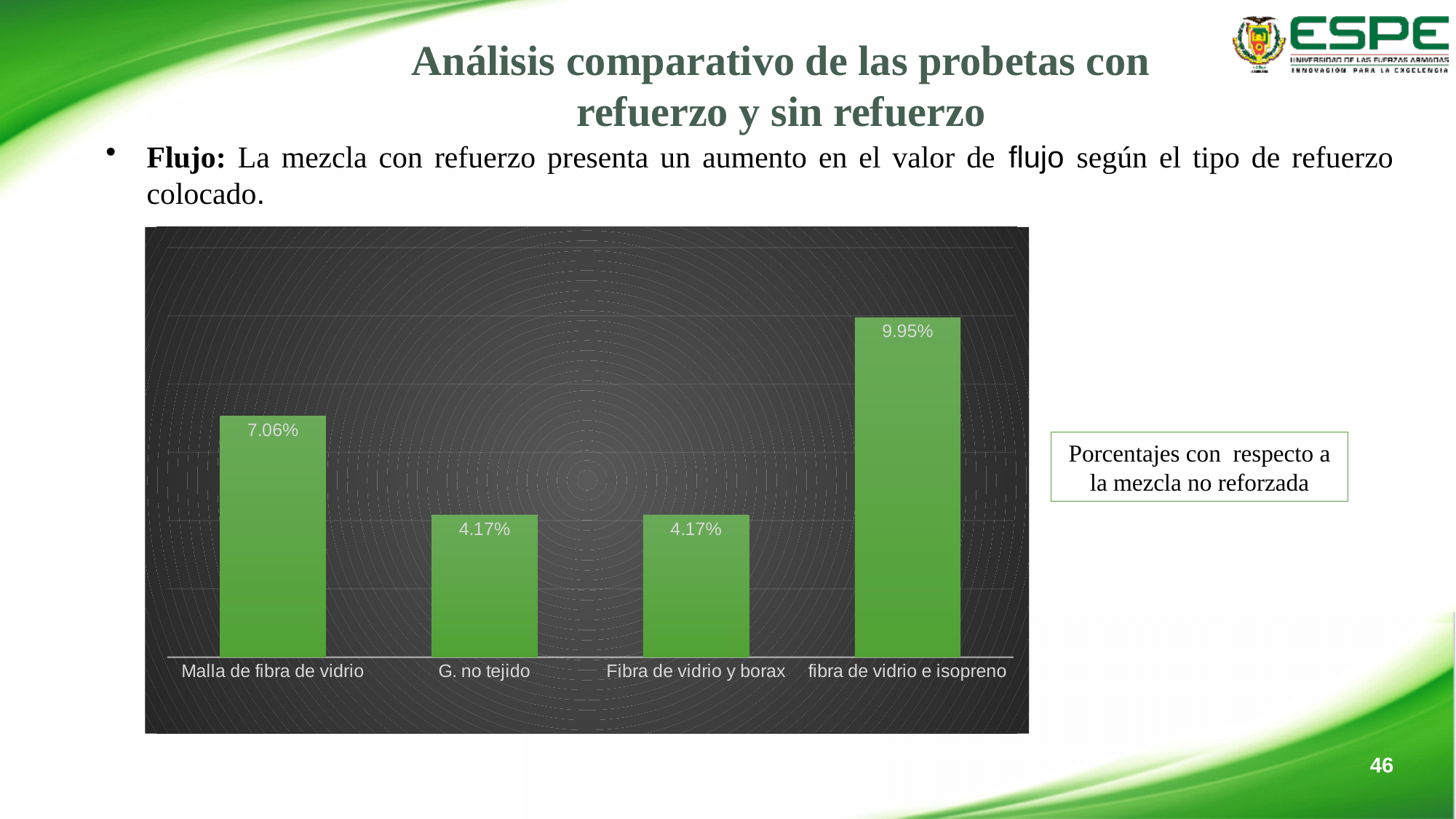
What is the difference between the values for Malla de fibra de vidrio and G. no tejido? 2.89% What is the value for Malla de fibra de vidrio? 7.06% Which category has the highest value? fibra de vidrio e isopreno How many categories are shown in the chart? 4 What is the difference between the values for fibra de vidrio e isopreno and Malla de fibra de vidrio? 2.89% What is the value for G. no tejido? 4.17% Which is larger, the value for Malla de fibra de vidrio or the value for Fibra de vidrio y borax? Malla de fibra de vidrio Which two categories have the same value? G. no tejido and Fibra de vidrio y borax What kind of chart is shown on the slide? bar chart What is the value for fibra de vidrio e isopreno? 9.95% What colour are the bars in the chart? green What is the value for Fibra de vidrio y borax? 4.17%